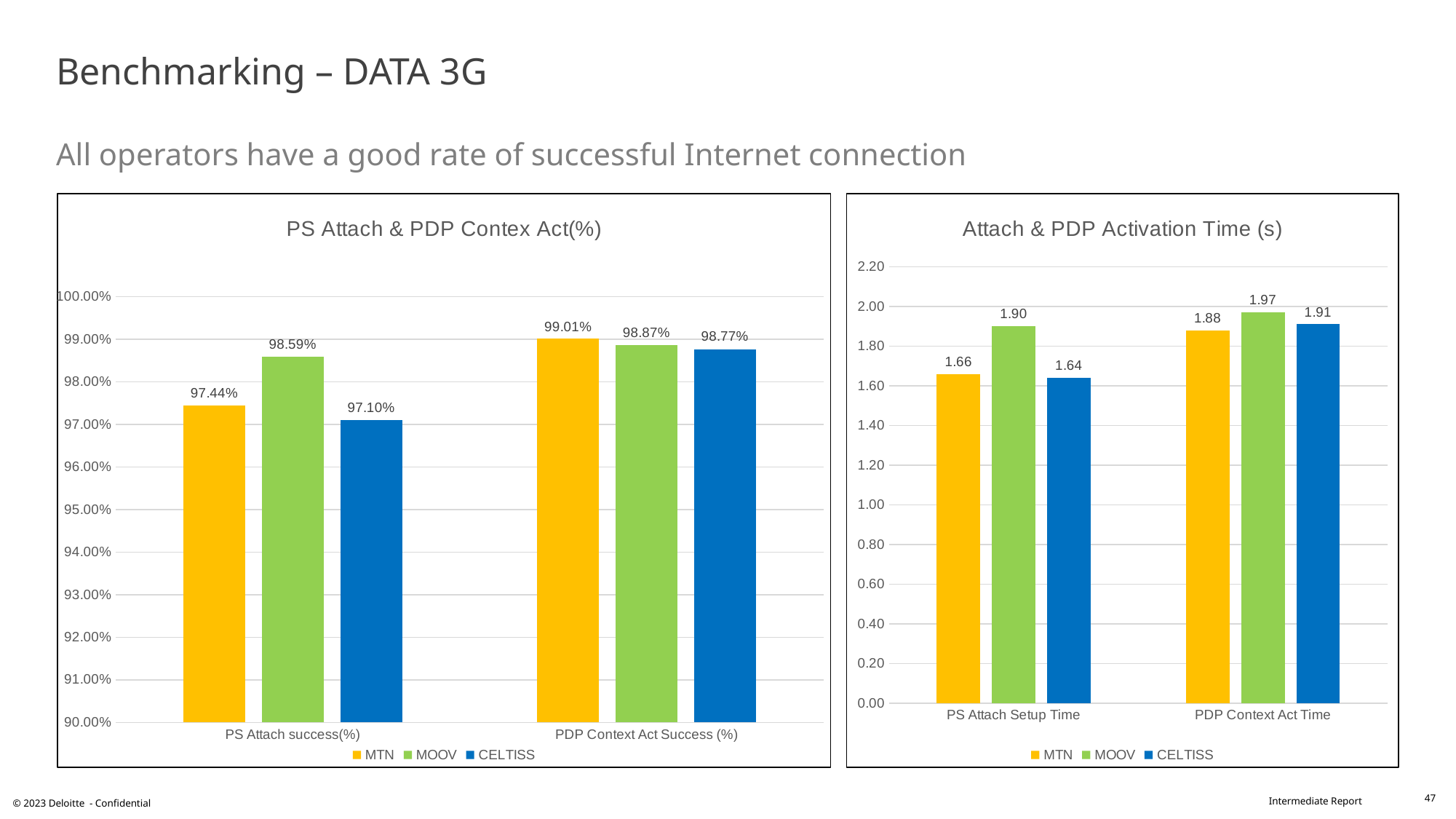
In the 'Attach & PDP Activation Time (s)' chart, what is the PS Attach Setup Time for MOOV? 1.90 In the 'Attach & PDP Activation Time (s)' chart, which operator has the highest PDP Context Act Time? MOOV In the 'PS Attach & PDP Contex Act(%)' chart, which operator has the highest PS Attach success(%)? MOOV What kind of chart is the 'Attach & PDP Activation Time (s)' chart? Bar chart In the 'PS Attach & PDP Contex Act(%)' chart, what is the PDP Context Act Success (%) value for CELTISS? 98.77% In the 'Attach & PDP Activation Time (s)' chart, what is the difference between MOOV's and MTN's PDP Context Act Time? 0.09 In the 'PS Attach & PDP Contex Act(%)' chart, which operator has the lowest PS Attach success(%)? CELTISS In the 'Attach & PDP Activation Time (s)' chart, which is larger: MTN's PS Attach Setup Time or CELTISS's PS Attach Setup Time? MTN's PS Attach Setup Time In the 'Attach & PDP Activation Time (s)' chart, what is the PDP Context Act Time for MTN? 1.88 In the 'PS Attach & PDP Contex Act(%)' chart, how many series does the legend list? 3 In the 'PS Attach & PDP Contex Act(%)' chart, what is the difference between MOOV's and CELTISS's PS Attach success(%)? 1.49% In the 'PS Attach & PDP Contex Act(%)' chart, what is the PS Attach success(%) value for MTN? 97.44%